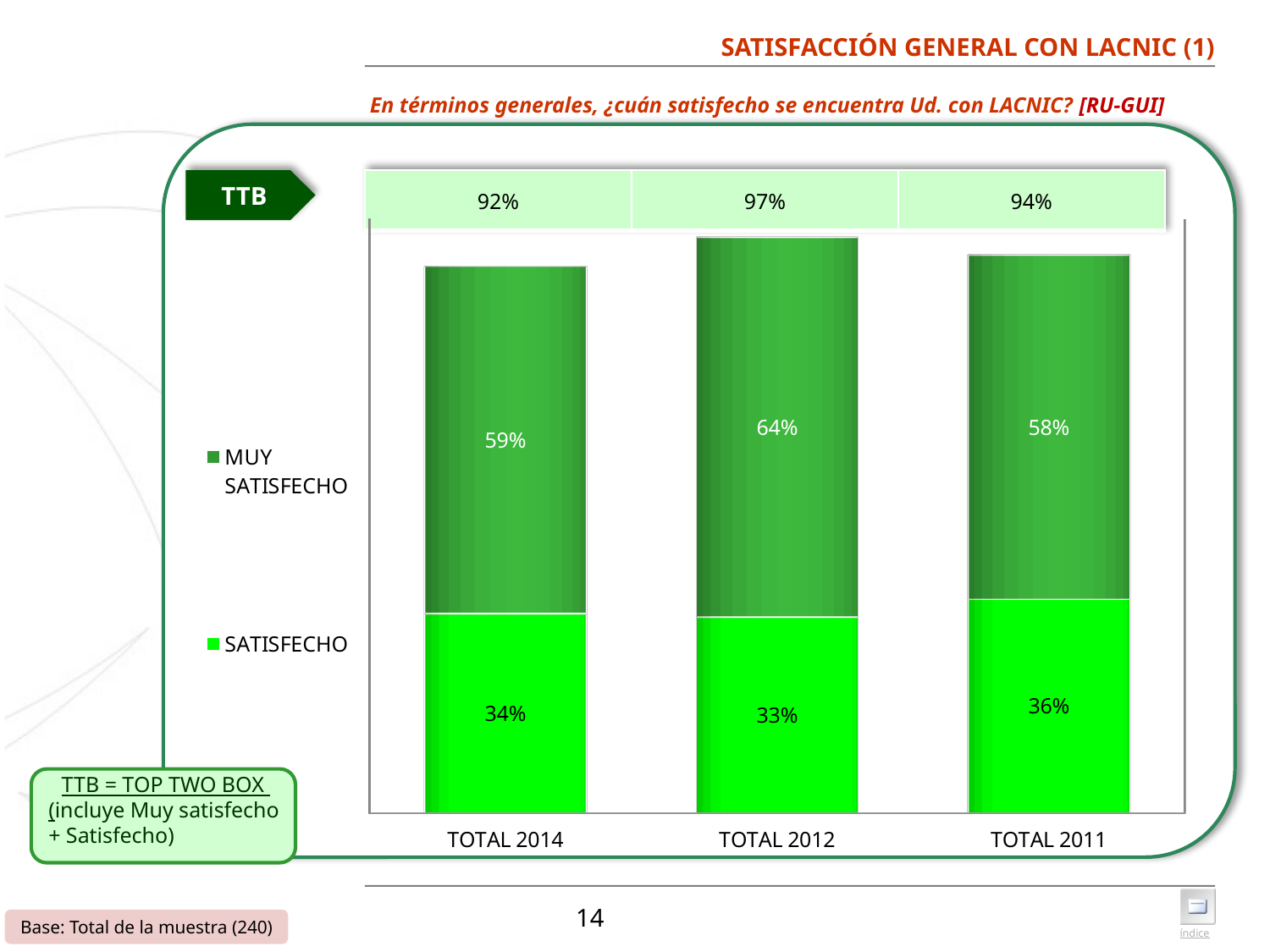
What kind of chart is shown on the slide? Stacked bar chart Which category has the highest MUY SATISFECHO percentage? TOTAL 2012 What is the MUY SATISFECHO value for TOTAL 2014? 59% Which TTB value is the lowest among the three categories? 92% (TOTAL 2014) Which is larger: the SATISFECHO value for TOTAL 2014 or for TOTAL 2011? TOTAL 2011 What is the difference between the MUY SATISFECHO values for TOTAL 2012 and TOTAL 2011? 6 percentage points What percentage of respondents were MUY SATISFECHO in TOTAL 2012? 64% Which category has the lowest SATISFECHO percentage? TOTAL 2012 How many categories are shown on the x axis of the chart? 3 What percentage of respondents were SATISFECHO in TOTAL 2011? 36% What is the TTB (Top Two Box) value shown for TOTAL 2012? 97% How many series does the legend list? 2